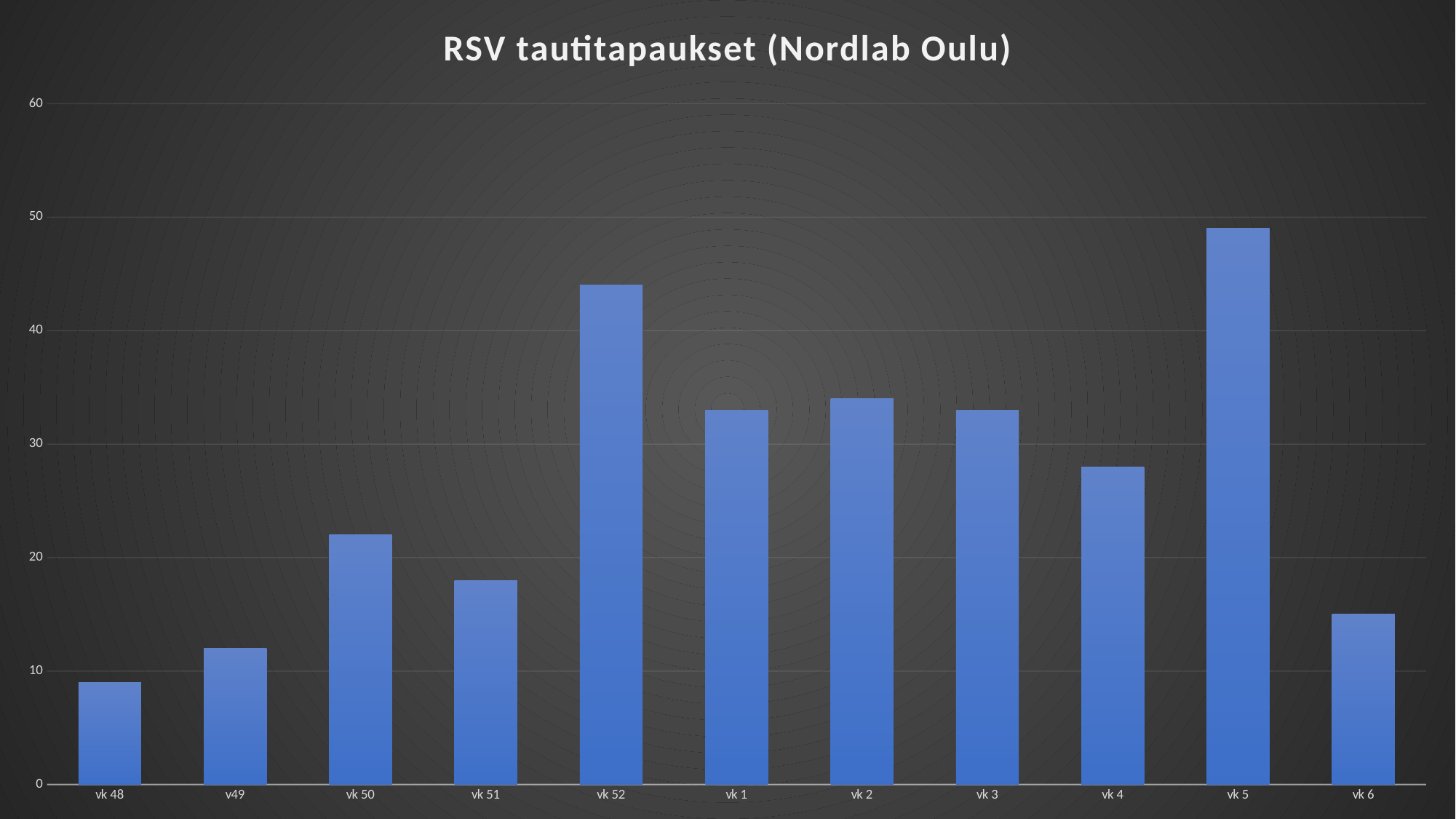
Is the value for vk 48 greater or less than 10? less Which week has the lowest value? vk 48 How many categories (weeks) are shown on the x axis? 11 Is the value for vk 4 greater or less than 30? less What is the title of the chart? RSV tautitapaukset (Nordlab Oulu) What type of chart is shown on the slide? bar chart Which week has the highest value? vk 5 Do the values rise or fall from vk 48 to vk 50? rise Is the value for vk 52 greater or less than 40? greater Which is larger, the value for vk 52 or the value for vk 1? vk 52 Which is larger, the value for vk 50 or the value for vk 51? vk 50